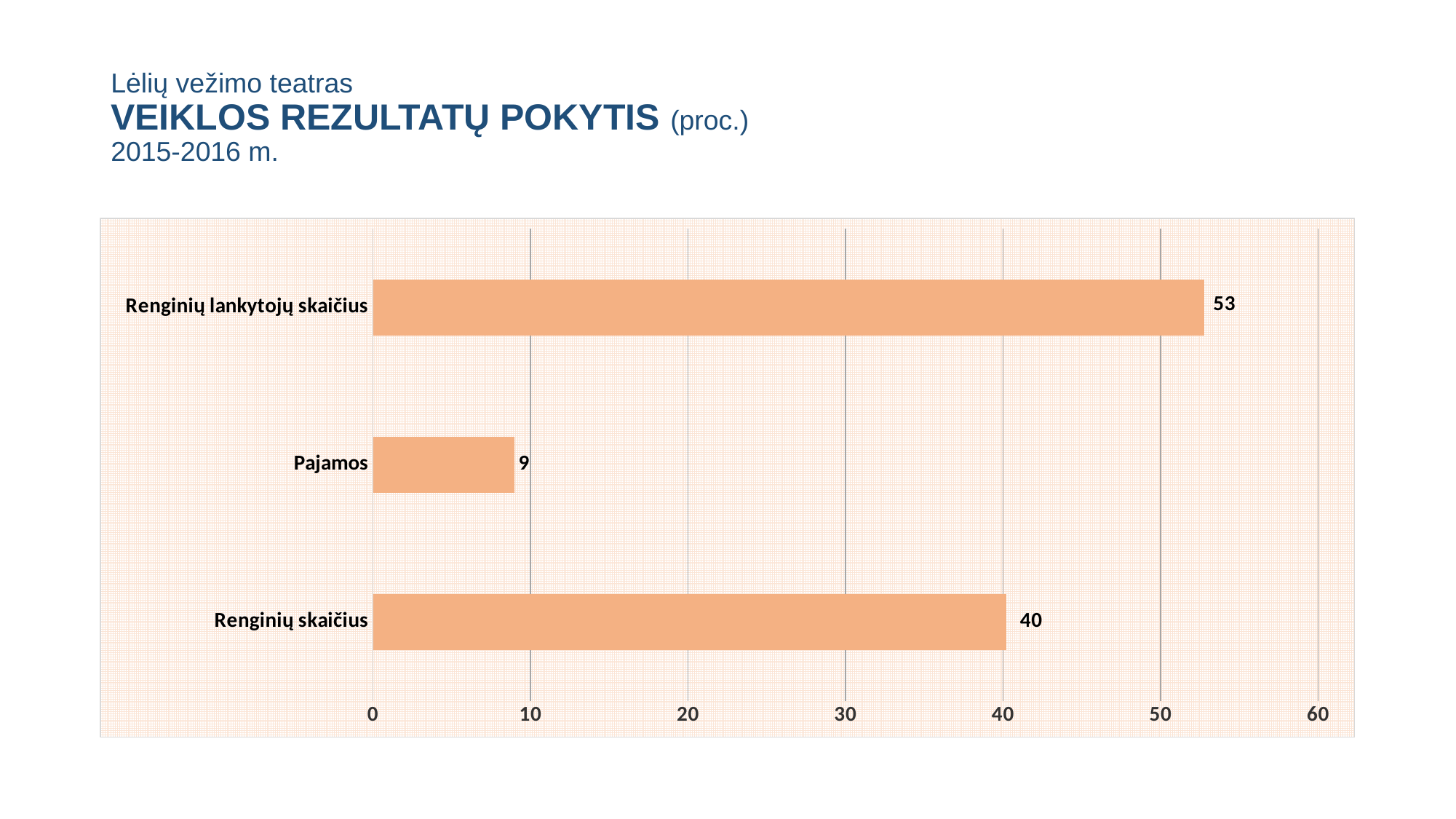
What kind of chart is shown on the slide? bar chart How many categories are shown in the chart? 3 What is the value for Renginių lankytojų skaičius? 53 Which category has the highest value? Renginių lankytojų skaičius Is the value for Renginių lankytojų skaičius greater or less than 50? greater Which is larger, the value for Pajamos or the value for Renginių skaičius? Renginių skaičius What is the difference between the values for Renginių lankytojų skaičius and Renginių skaičius? 13 Which category has the lowest value? Pajamos What is the value for Pajamos? 9 What is the highest value shown on the horizontal axis? 60 What is the difference between the values for Renginių skaičius and Pajamos? 31 What is the value for Renginių skaičius? 40